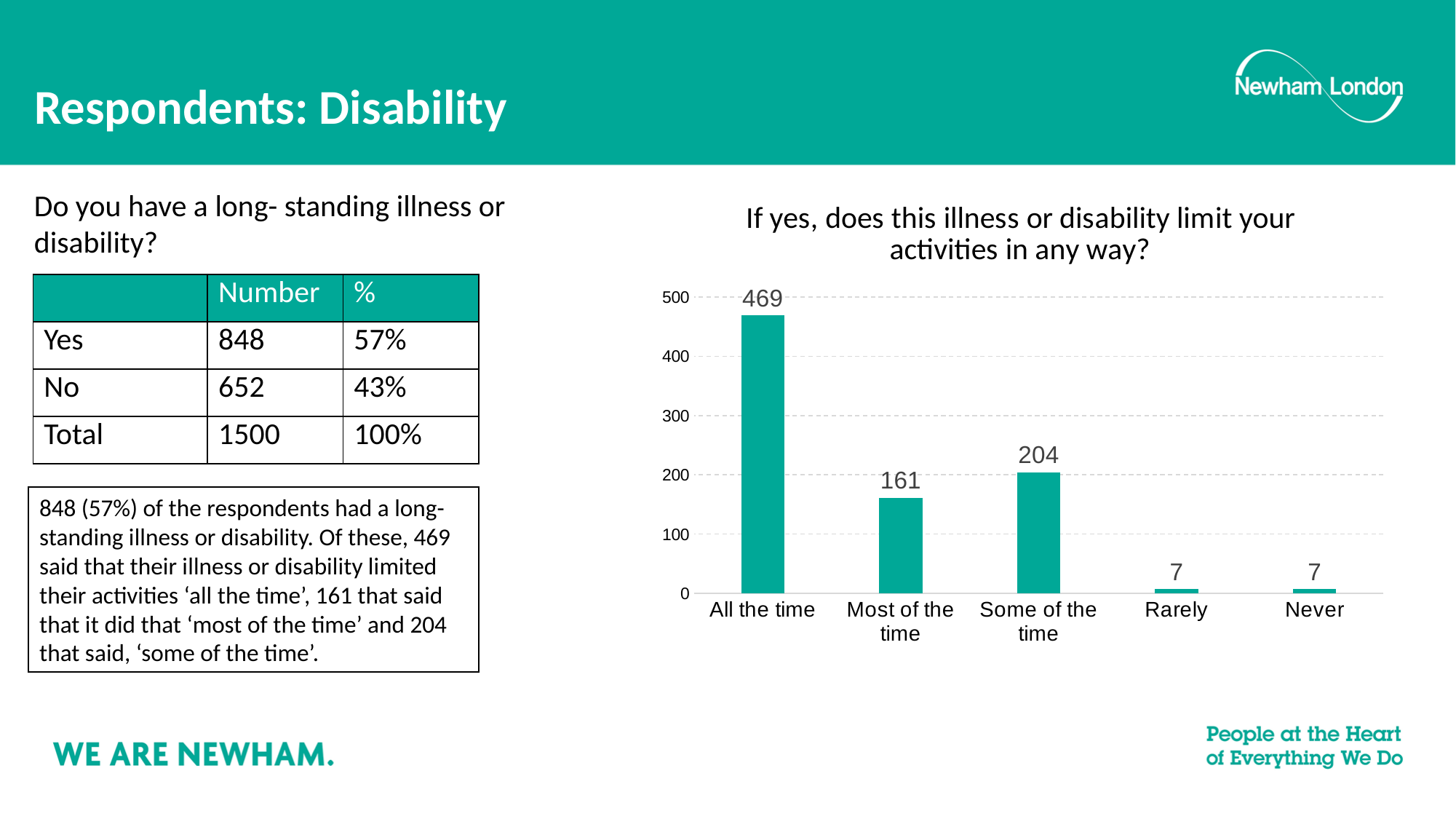
What is the value for 'Rarely' in the chart? 7 What is the difference between the values for 'Some of the time' and 'Most of the time'? 43 What kind of chart is shown on the slide? bar chart What is the value for 'Some of the time' in the chart? 204 How many categories are shown on the x axis of the chart? 5 Is the value for 'Most of the time' greater or less than 200? less What is the value for 'Most of the time' in the chart? 161 Which category has the highest value in the chart? All the time What is the value for 'All the time' in the chart? 469 What is the difference between the values for 'All the time' and 'Some of the time'? 265 Which is larger, the value for 'Most of the time' or 'Some of the time'? Some of the time What is the title of the chart? If yes, does this illness or disability limit your activities in any way?